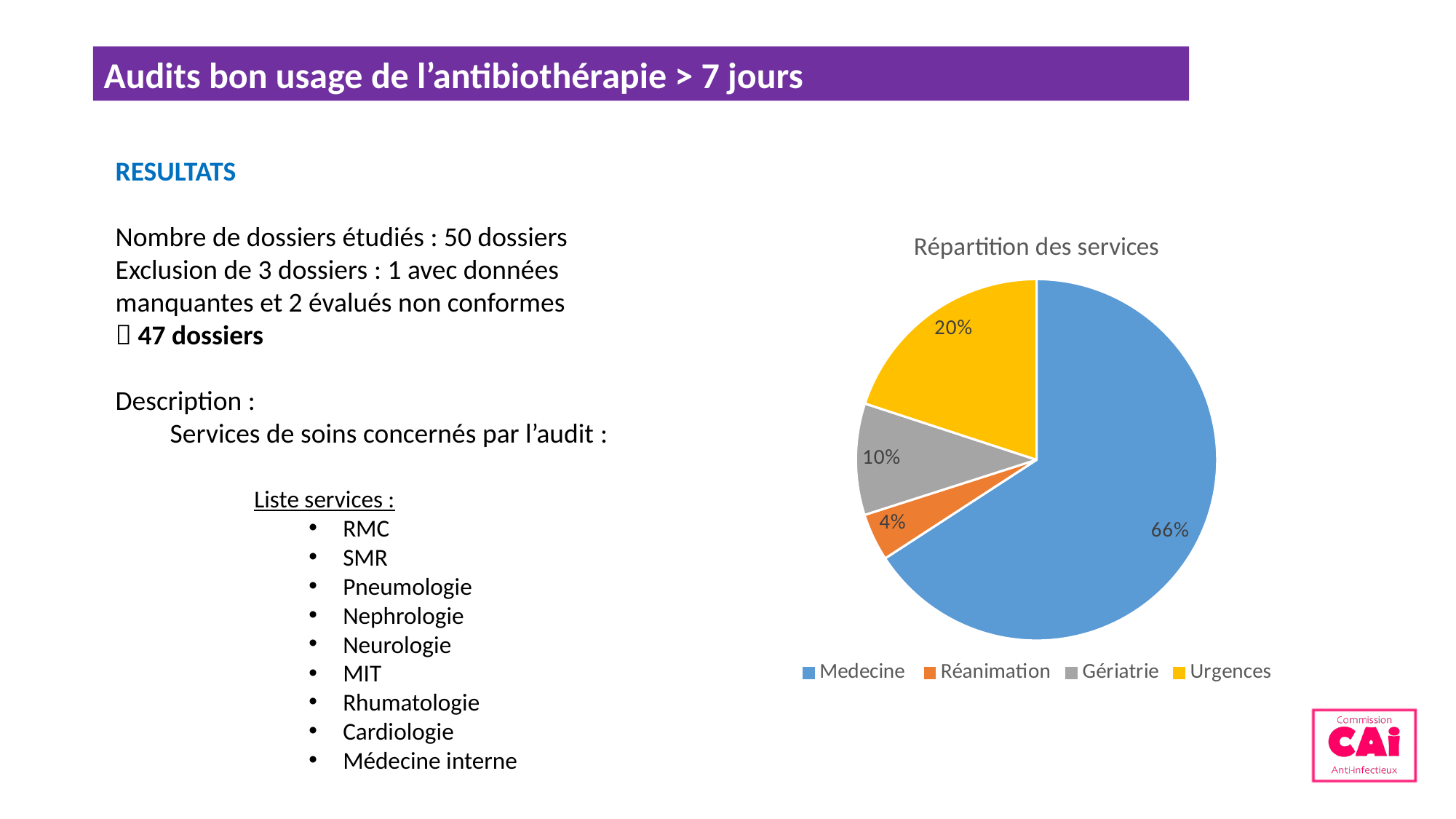
Which service has the smallest slice of the pie? Réanimation What share of the pie does Medecine represent? 66% What share of the pie does Réanimation represent? 4% What kind of chart is shown on the slide? Pie chart Which slice is larger, Gériatrie or Réanimation? Gériatrie Which service has the largest slice of the pie? Medecine What share of the pie does Gériatrie represent? 10% What is the title of the chart? Répartition des services What is the difference in percentage points between the Urgences and Gériatrie slices? 10 Which colour represents Urgences in the pie chart? Yellow How many slices does the pie chart have? 4 What share of the pie does Urgences represent? 20%